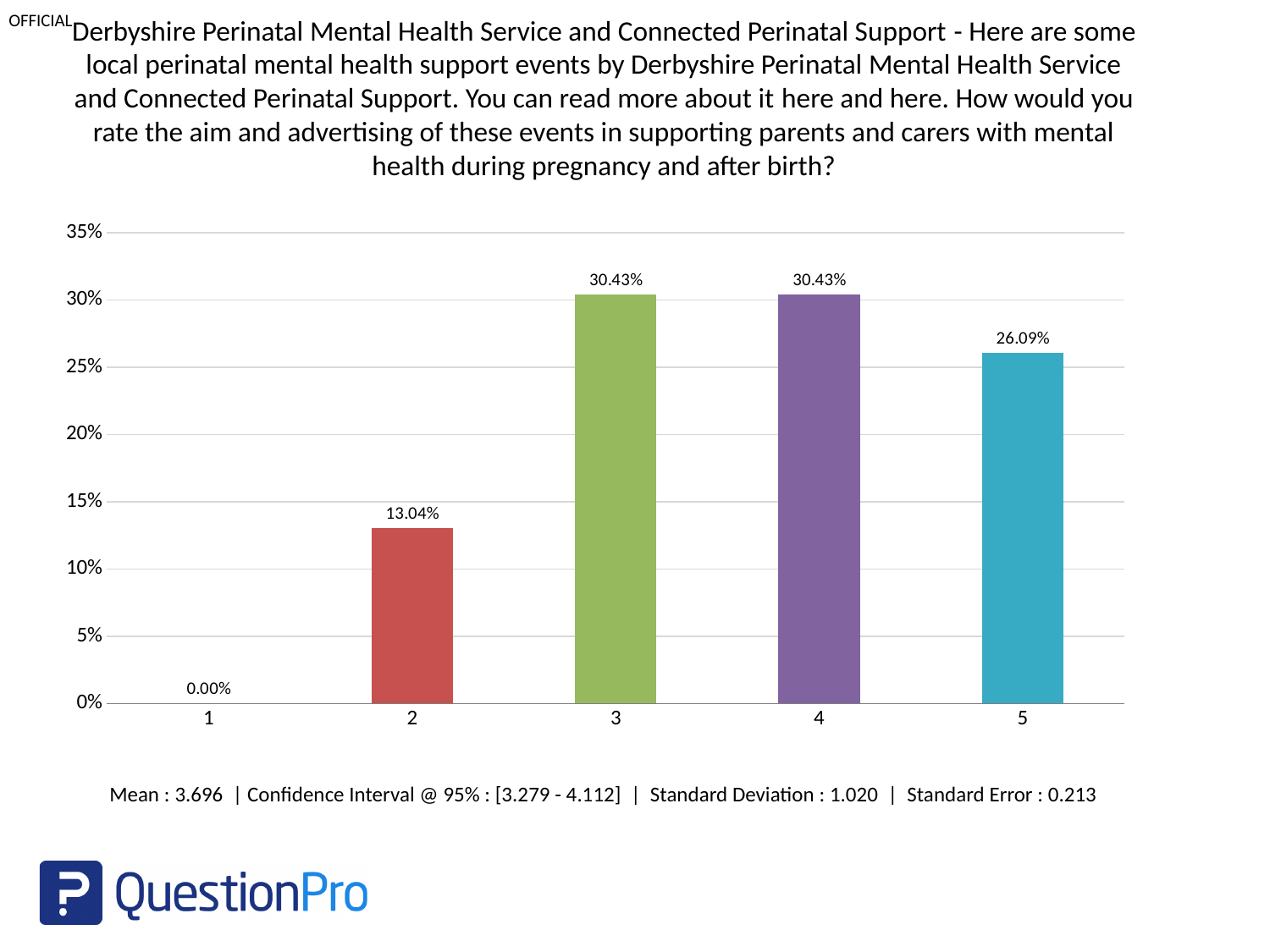
What mean value is reported below the chart? 3.696 What is the value for rating 1? 0.00% What kind of chart is shown on the slide? bar chart What is the value for rating 2? 13.04% What is the value for rating 3? 30.43% Which rating category has the lowest value? 1 What is the difference between the values for rating 3 and rating 2? 17.39% Which is larger, the value for rating 2 or the value for rating 5? 5 What is the value for rating 5? 26.09% What is the difference between the values for rating 4 and rating 5? 4.34% How many rating categories are shown on the x axis? 5 Is the value for rating 4 greater or less than 25%? greater